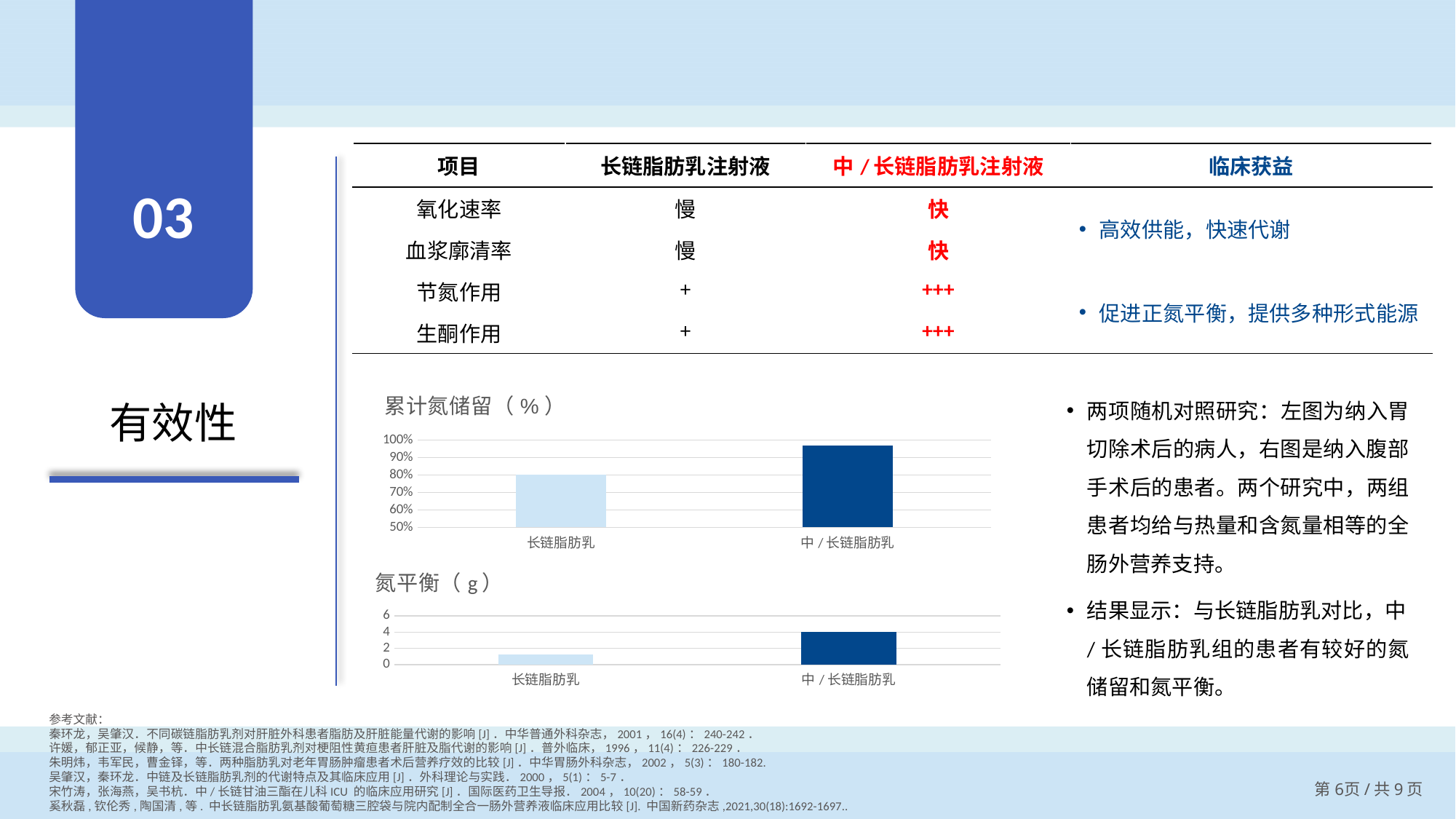
How many categories are shown in the 氮平衡（g） chart? 2 In the 累计氮储留（%） chart, which is larger: the value for 长链脂肪乳 or the value for 中 / 长链脂肪乳? 中 / 长链脂肪乳 What kind of chart is the 累计氮储留（%） chart? bar chart In the 氮平衡（g） chart, is the value for 中 / 长链脂肪乳 greater or less than 2? greater In the 氮平衡（g） chart, which category has the highest value? 中 / 长链脂肪乳 In the 累计氮储留（%） chart, is the value for 长链脂肪乳 greater or less than 90%? less In the 累计氮储留（%） chart, which category has the lowest value? 长链脂肪乳 In the 累计氮储留（%） chart, is the value for 中 / 长链脂肪乳 greater or less than 90%? greater In the 氮平衡（g） chart, which category has the lowest value? 长链脂肪乳 In the 累计氮储留（%） chart, which category has the highest value? 中 / 长链脂肪乳 What kind of chart is the 氮平衡（g） chart? bar chart